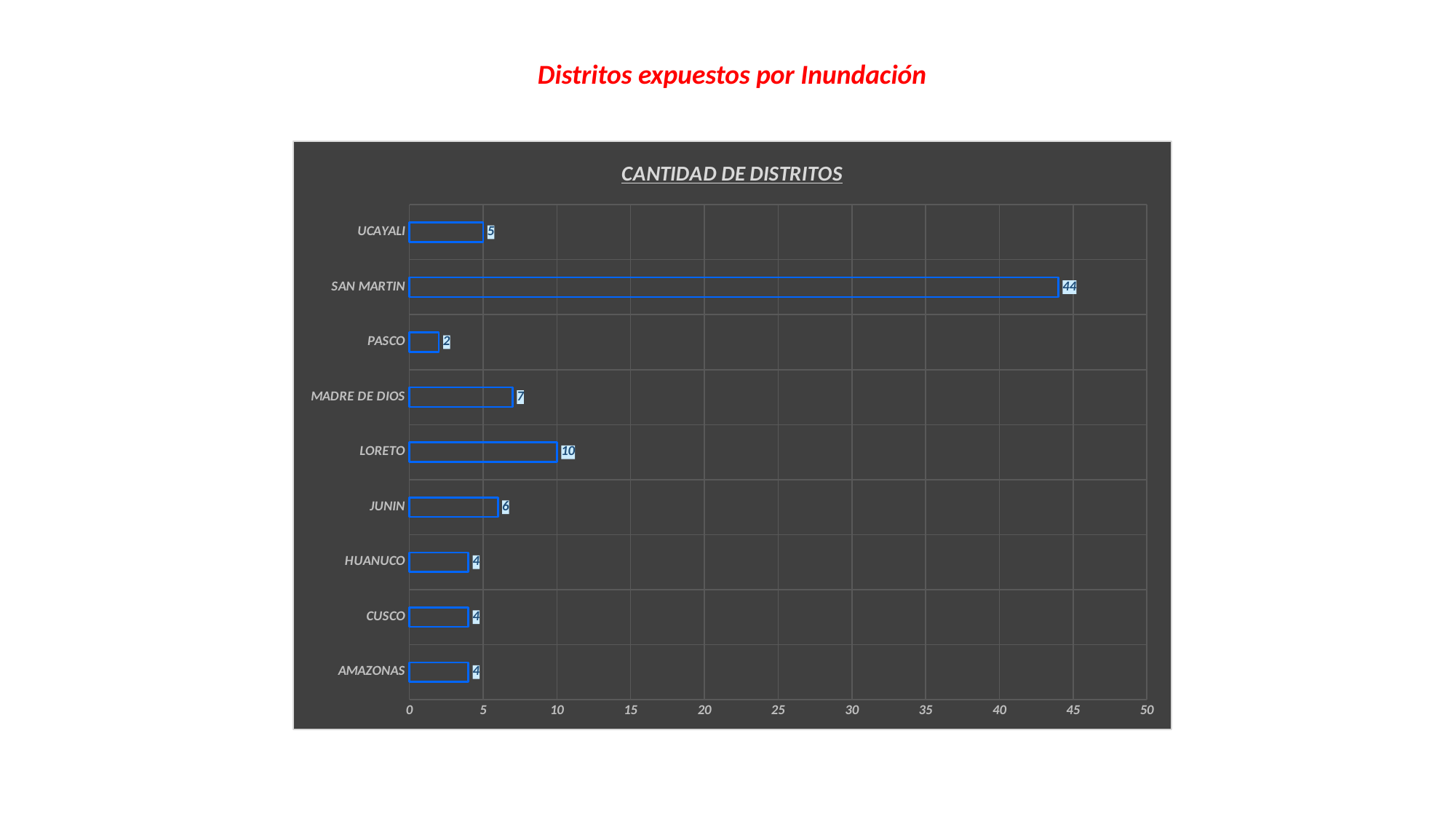
Is the value for SAN MARTIN greater or less than 40? greater What is the title of the chart? CANTIDAD DE DISTRITOS How many categories are shown in the chart? 9 What is the value for PASCO? 2 Which is larger, the value for JUNIN or the value for UCAYALI? JUNIN Which category has the lowest value? PASCO What kind of chart is shown? bar chart What is the difference between the values for SAN MARTIN and LORETO? 34 What is the value for MADRE DE DIOS? 7 What is the value for SAN MARTIN? 44 What is the value for LORETO? 10 Which category has the highest value? SAN MARTIN